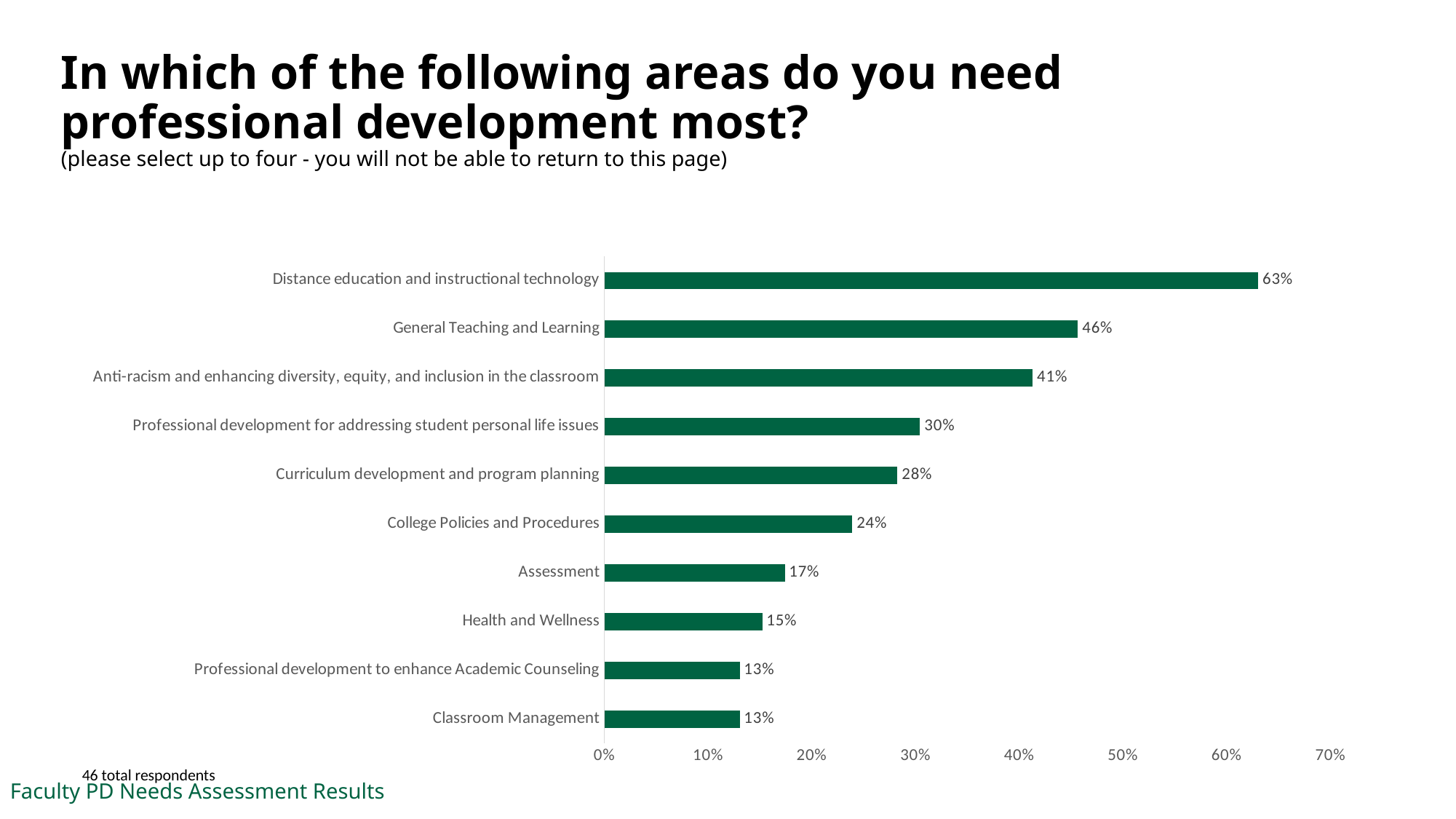
What is the difference between the values for General Teaching and Learning and Assessment? 29% What percentage of respondents selected Distance education and instructional technology? 63% Which area has the highest percentage? Distance education and instructional technology How many total respondents are noted on the slide? 46 What percentage is shown for Health and Wellness? 15% What is the lowest percentage shown on the chart? 13% Which is larger: the value for College Policies and Procedures or the value for Curriculum development and program planning? Curriculum development and program planning What is the value for General Teaching and Learning? 46% Is the value for Anti-racism and enhancing diversity, equity, and inclusion in the classroom greater or less than 40%? greater What is the highest value shown on the x axis? 70% How many areas (categories) are shown on the chart? 10 What kind of chart is shown on the slide? bar chart